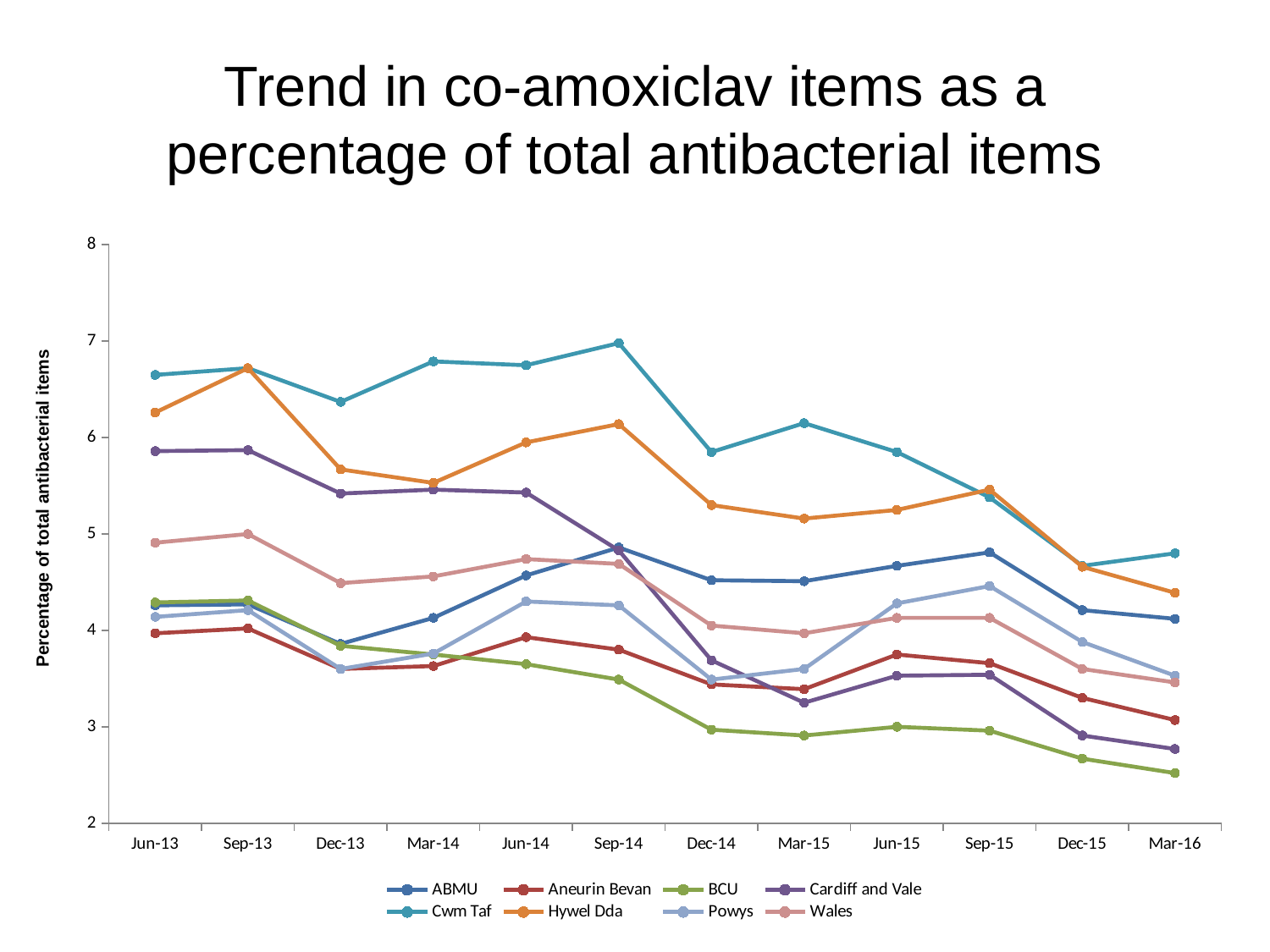
What is the label on the y axis? Percentage of total antibacterial items Is the value for Wales at Dec-13 greater or less than 4? greater Does the BCU line generally rise or fall from Jun-13 to Mar-16? fall Which series has the highest value at Jun-13? Cwm Taf Is the value for Cwm Taf at Sep-14 greater or less than 6? greater At Dec-14, which is higher: BCU or Aneurin Bevan? Aneurin Bevan How many series does the legend list? 8 How many time points are plotted along the x axis? 12 What kind of chart is shown on the slide? line chart Is the value for BCU at Mar-16 greater or less than 3? less Which series has the lowest value at Mar-16? BCU At Dec-13, which is higher: Cwm Taf or Hywel Dda? Cwm Taf